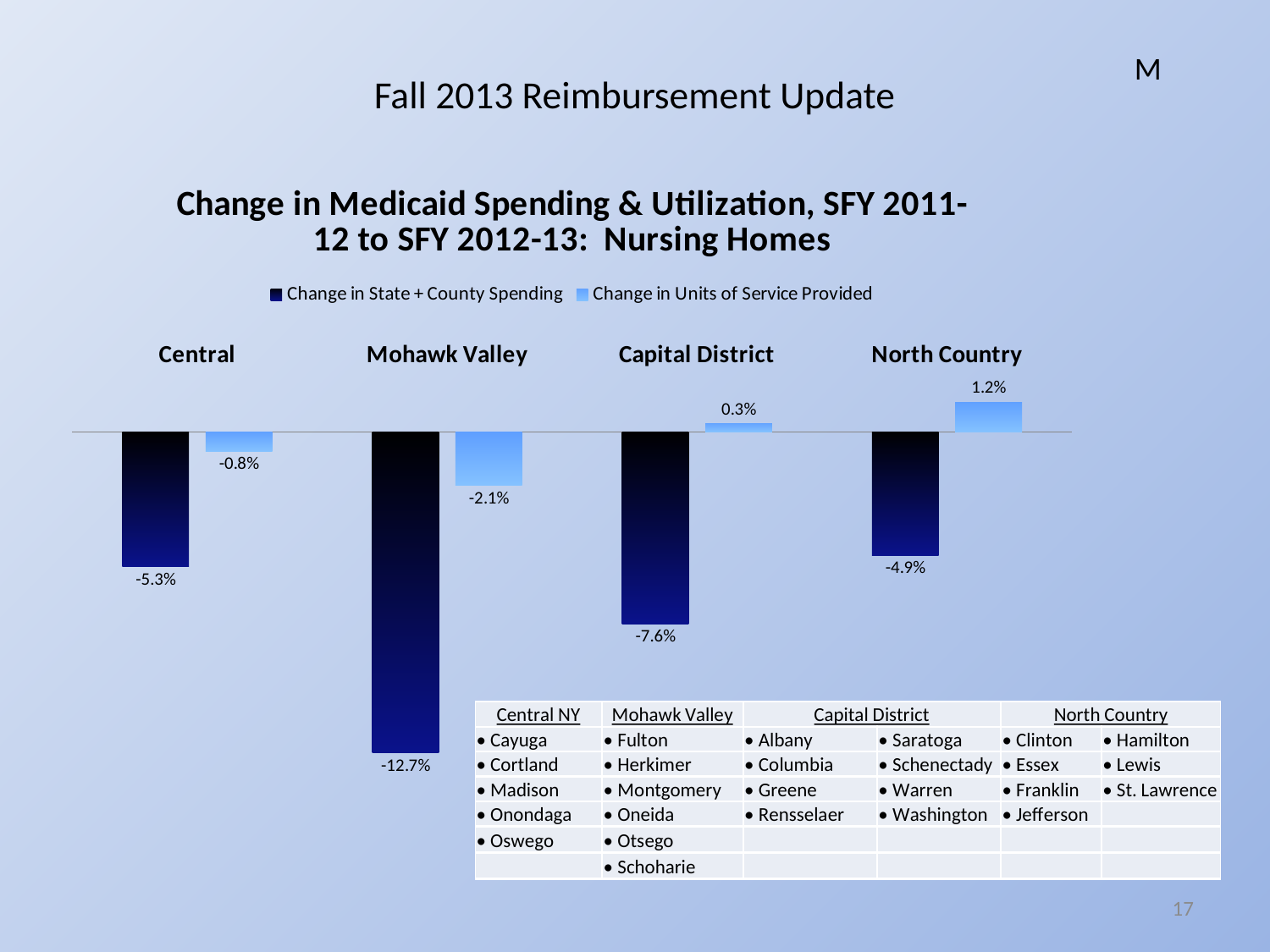
What is the Change in State + County Spending for Capital District? -7.6% Which is larger, the Change in Units of Service Provided for Capital District or for Mohawk Valley? Capital District Which region has the highest Change in Units of Service Provided? North Country Which region has the lowest Change in State + County Spending? Mohawk Valley How many series does the legend list? 2 What is the title of the chart? Change in Medicaid Spending & Utilization, SFY 2011-12 to SFY 2012-13: Nursing Homes How many regions are shown in the chart? 4 What is the difference between the Change in State + County Spending for Central and North Country? 0.4% What is the Change in State + County Spending for Mohawk Valley? -12.7% What is the Change in Units of Service Provided for North Country? 1.2% What is the Change in Units of Service Provided for Central? -0.8% What kind of chart is shown on the slide? Bar chart